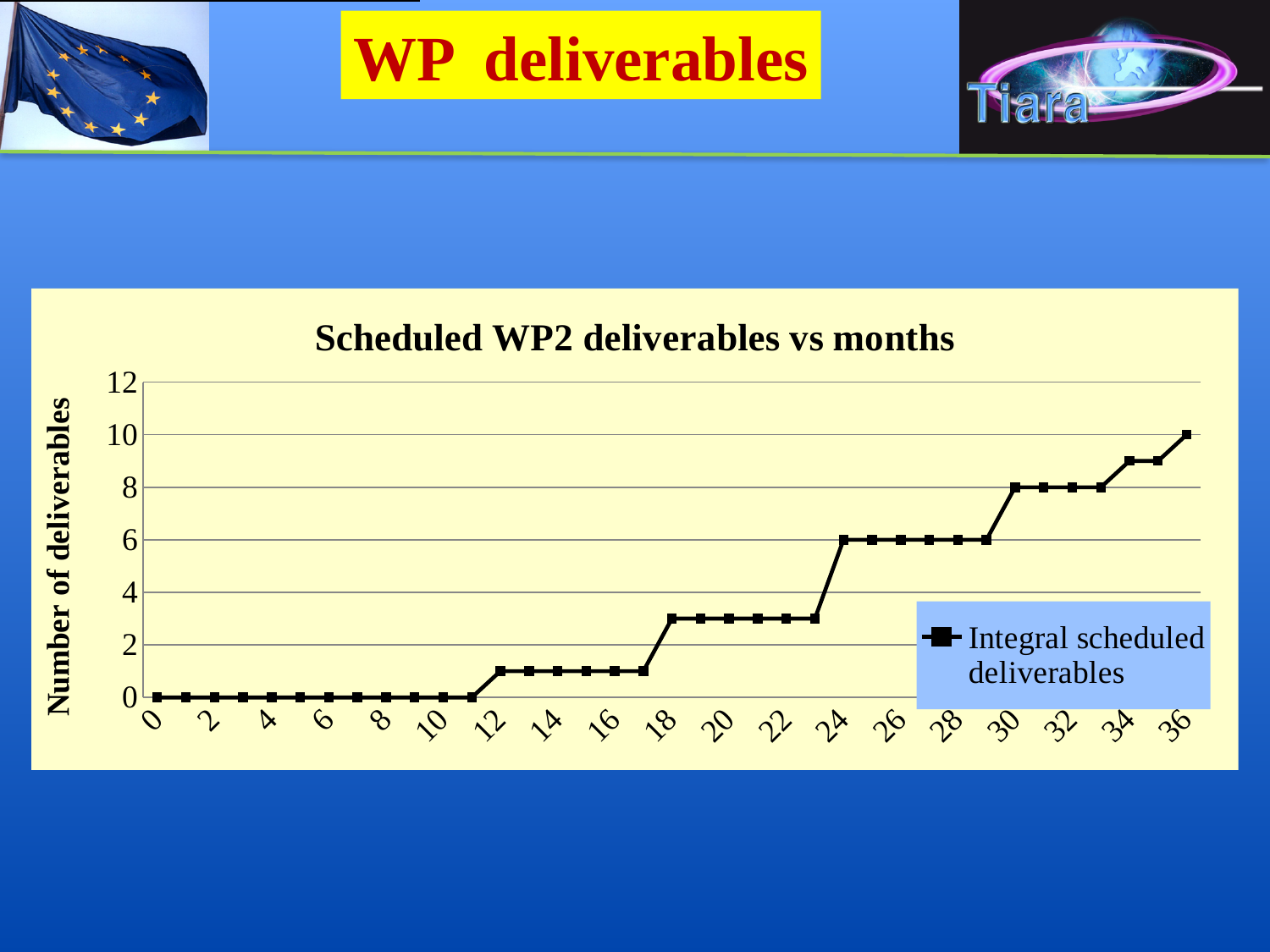
How many series does the legend list? 1 Is the value at month 12 greater or less than 2? less What is the number of deliverables at month 36? 10 Do the values rise or fall as the months increase? rise What kind of chart is shown on the slide? line chart What is the highest value reached by the line? 10 What is the number of deliverables at month 30? 8 What is the title of the chart? Scheduled WP2 deliverables vs months Is the value at month 18 greater or less than 2? greater What is the number of deliverables at month 24? 6 What is the lowest value on the line? 0 What is the name of the series shown in the legend? Integral scheduled deliverables